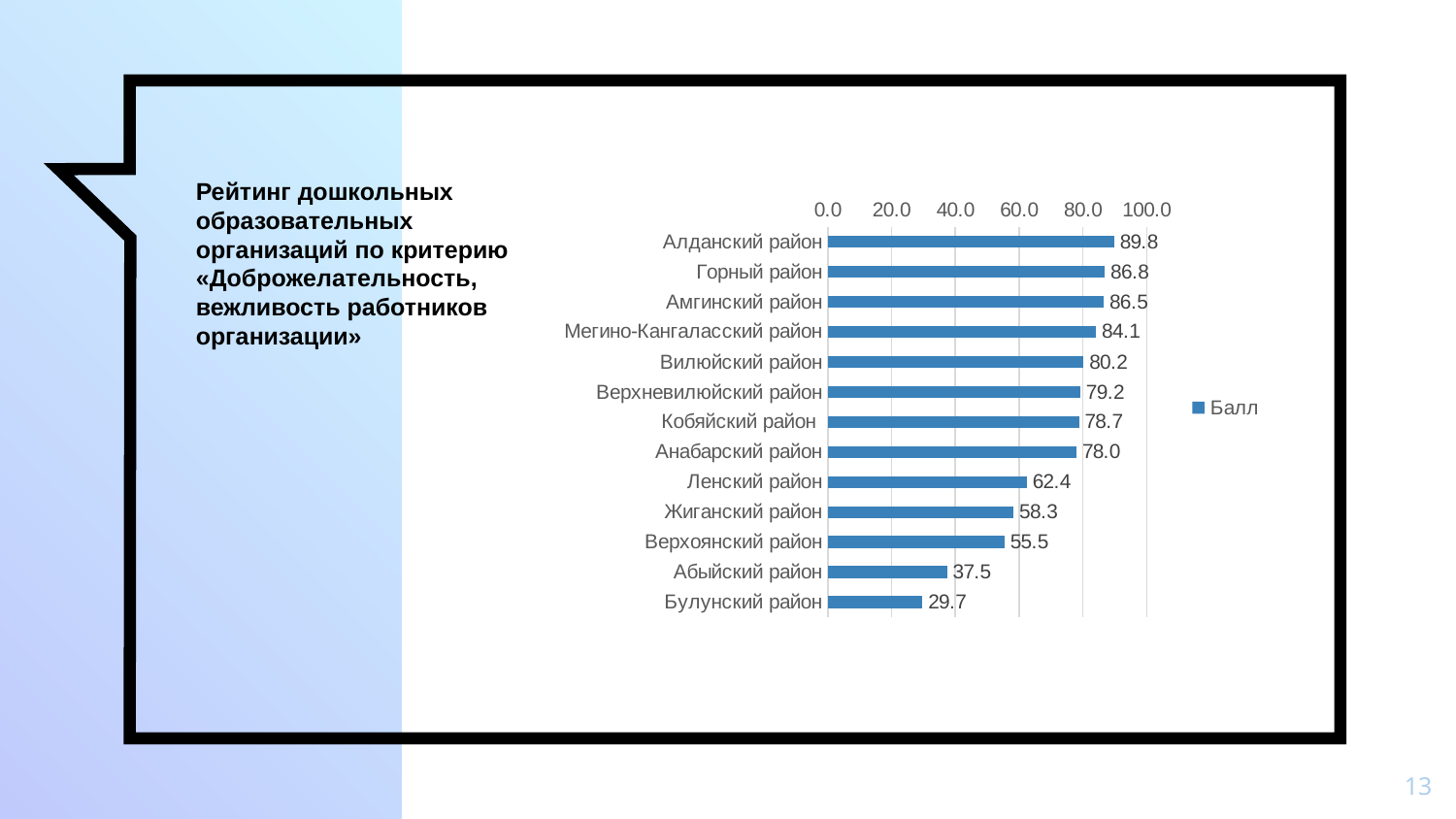
Which district has the highest value? Алданский район What is the value for Булунский район? 29.7 What kind of chart is shown on the slide? bar chart Is the value for Абыйский район greater or less than 40.0? less What is the legend entry of the chart? Балл What is the value for Мегино-Кангаласский район? 84.1 What is the value for Алданский район? 89.8 Which district has the lowest value? Булунский район How many districts are shown in the chart? 13 How many series does the legend list? 1 Which is larger, the value for Ленский район or Жиганский район? Ленский район What is the difference between the values for Алданский район and Булунский район? 60.1